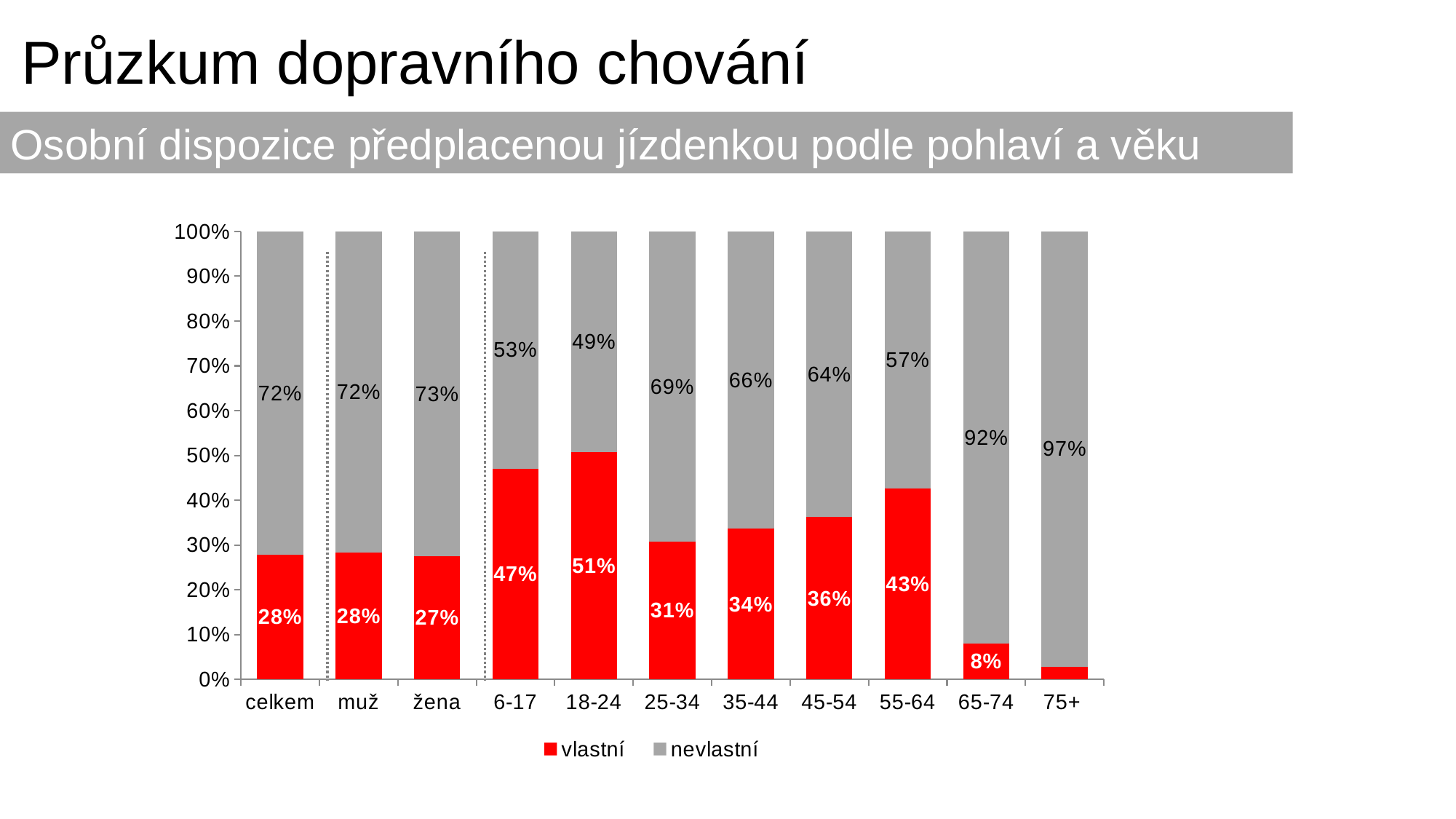
What is the value of vlastní for the 18-24 category? 51% What is the value of vlastní for žena? 27% What is the difference between the vlastní values for 55-64 and 25-34? 12% Which is larger, the vlastní value for 6-17 or for 45-54? 6-17 How many series does the legend list? 2 What is the value of nevlastní for the 65-74 category? 92% Which colour represents the nevlastní series? grey Which category has the highest vlastní value? 18-24 Is the vlastní value for 75+ greater or less than 10%? less What kind of chart is shown on the slide? stacked bar chart Which category has the lowest vlastní value? 75+ How many categories are shown on the x axis? 11